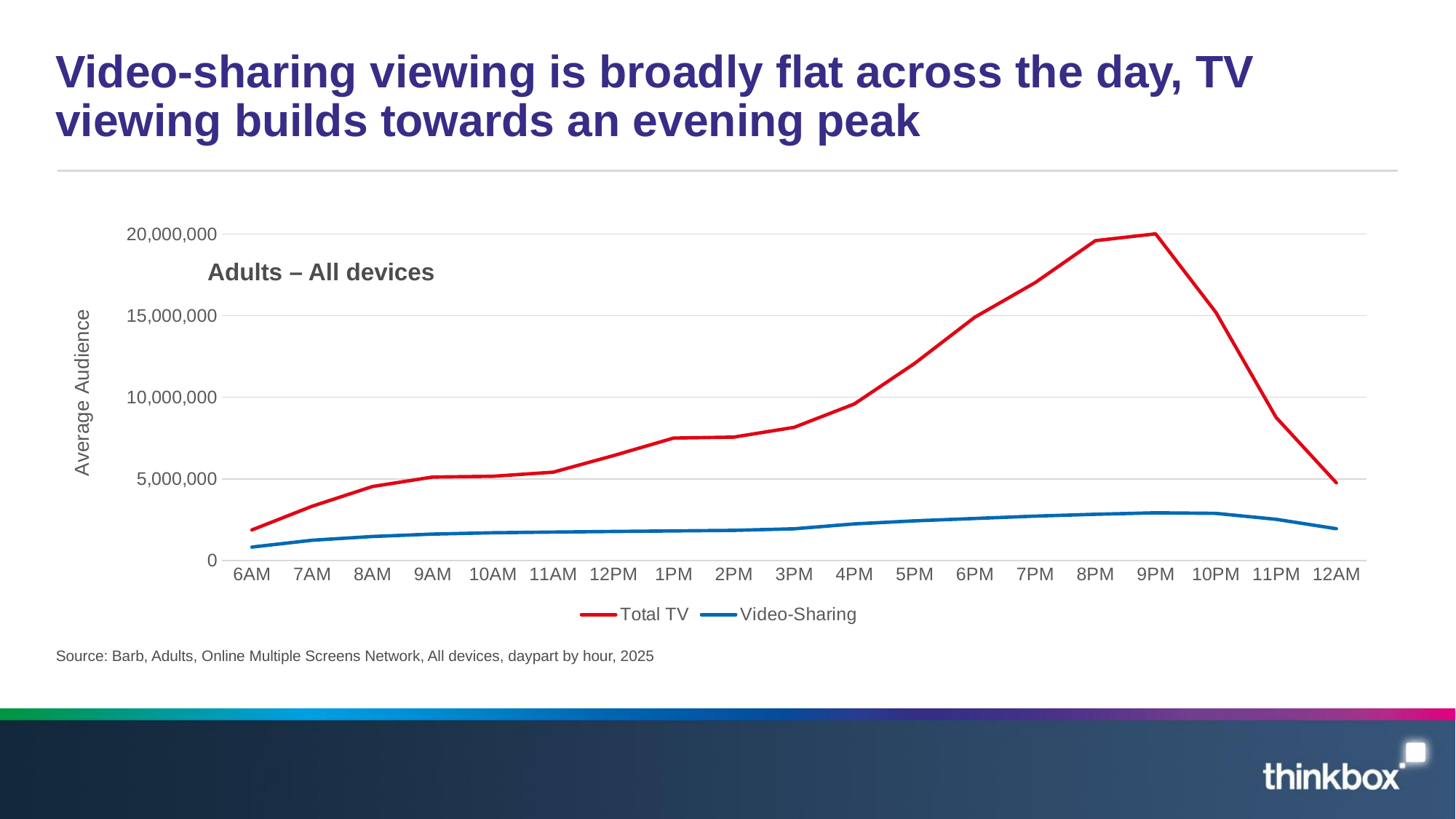
Does the Total TV series rise or fall between 6AM and 9PM? rise Is the Total TV value at 9PM greater or less than 15,000,000? greater At what hour is the Total TV series at its lowest value? 6AM How many series does the legend list? 2 Which series has the larger value at 8PM, Total TV or Video-Sharing? Total TV Does the Total TV series rise or fall between 9PM and 12AM? fall How many hourly points are plotted along the x axis? 19 At what hour does the Total TV series reach its highest value? 9PM Is the Video-Sharing value at 9PM greater or less than 5,000,000? less What kind of chart is shown on the slide? line chart What is the label on the vertical axis? Average Audience